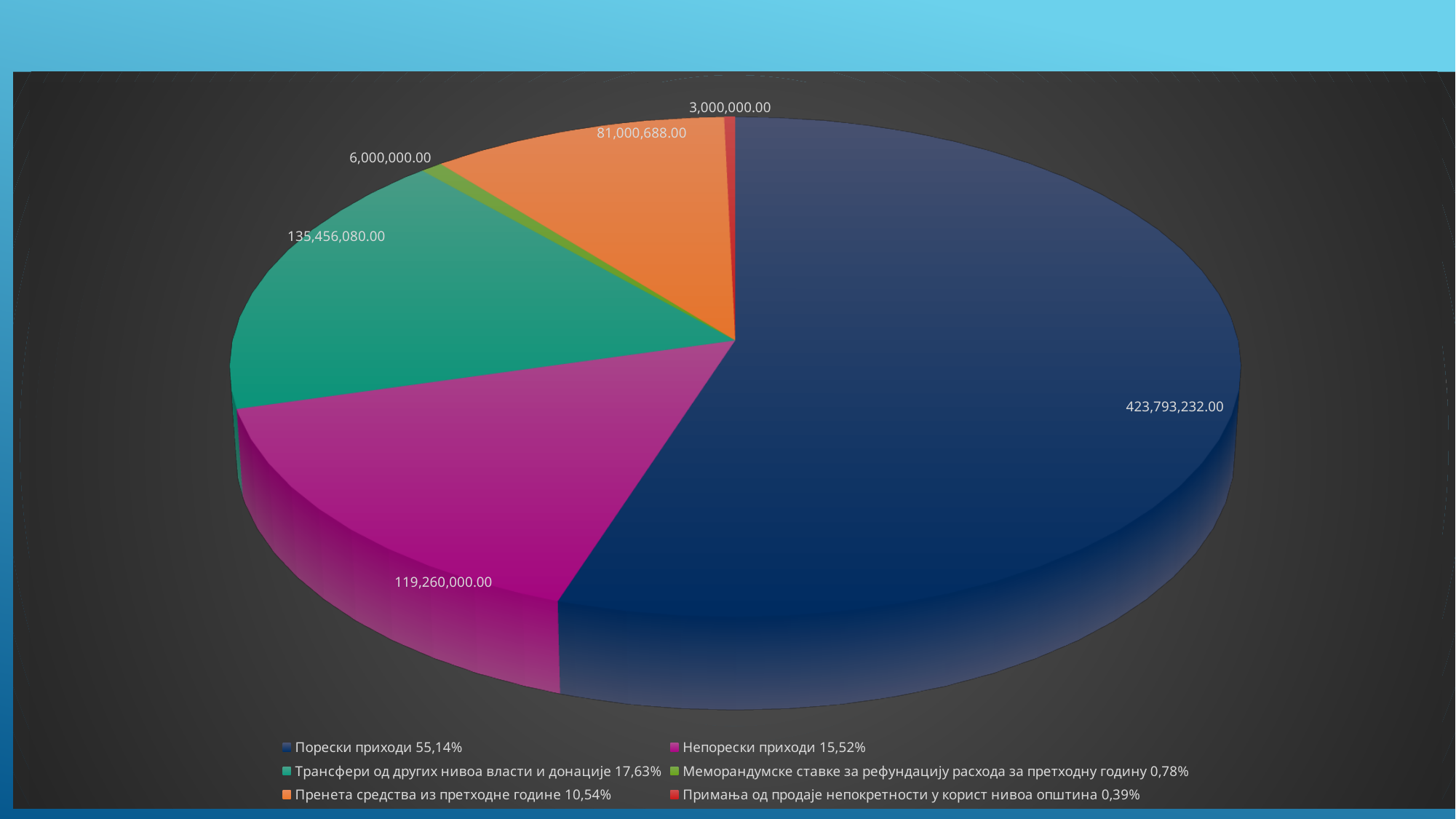
What is the value of the Пренета средства из претходне године slice? 81,000,688.00 What is the value of the Трансфери од других нивоа власти и донације slice? 135,456,080.00 Which category has the smallest slice of the pie? Примања од продаје непокретности у корист нивоа општина What colour is the Порески приходи slice? Dark blue Which is larger: the Непорески приходи slice or the Пренета средства из претходне године slice? Непорески приходи What share of the pie does Непорески приходи represent, as shown in the legend? 15,52% What type of chart is shown on the slide? Pie chart How many slices does the pie chart have? 6 Which category has the largest slice of the pie? Порески приходи What is the value of the Порески приходи slice? 423,793,232.00 What share of the pie does Меморандумске ставке за рефундацију расхода за претходну годину represent, as shown in the legend? 0,78% What is the difference between the Трансфери од других нивоа власти и донације value and the Непорески приходи value? 16,196,080.00